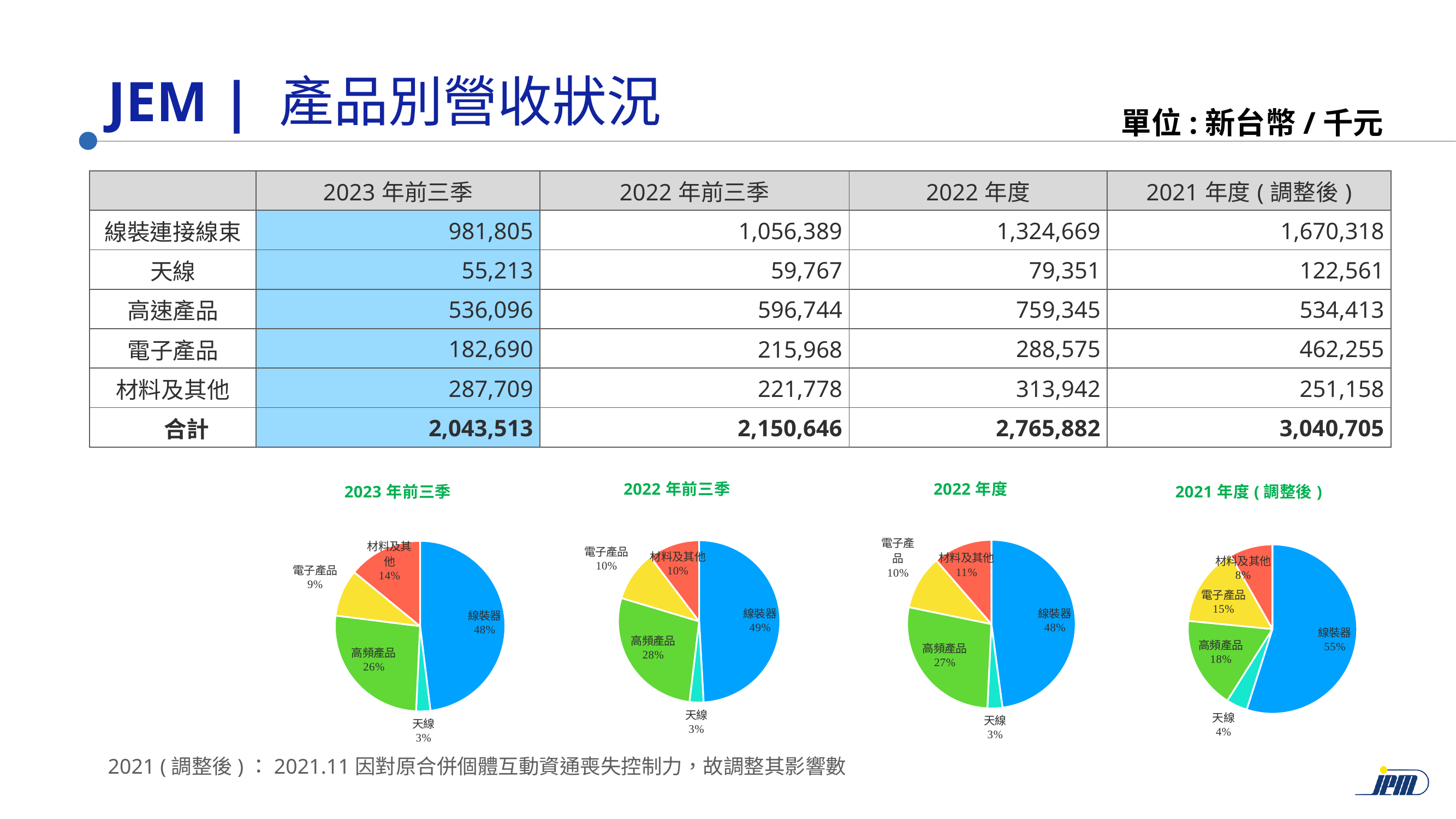
How many slices does the "2022 年前三季" pie chart have? 5 In the "2022 年度" pie chart, which category has the largest slice? 線裝器 In the "2021 年度（調整後）" pie chart, which category has the smallest slice? 天線 In the "2022 年度" pie chart, what share does 電子產品 have? 10% In the "2023 年前三季" pie chart, which is larger, 電子產品 or 材料及其他? 材料及其他 In the "2023 年前三季" pie chart, what share does 材料及其他 have? 14% In the "2021 年度（調整後）" pie chart, what is the difference in percentage points between 高頻產品 and 電子產品? 3 In the "2023 年前三季" pie chart, what share does 線裝器 have? 48% What kind of chart is used for "2022 年度"? Pie chart How many pie charts are shown on the slide? 4